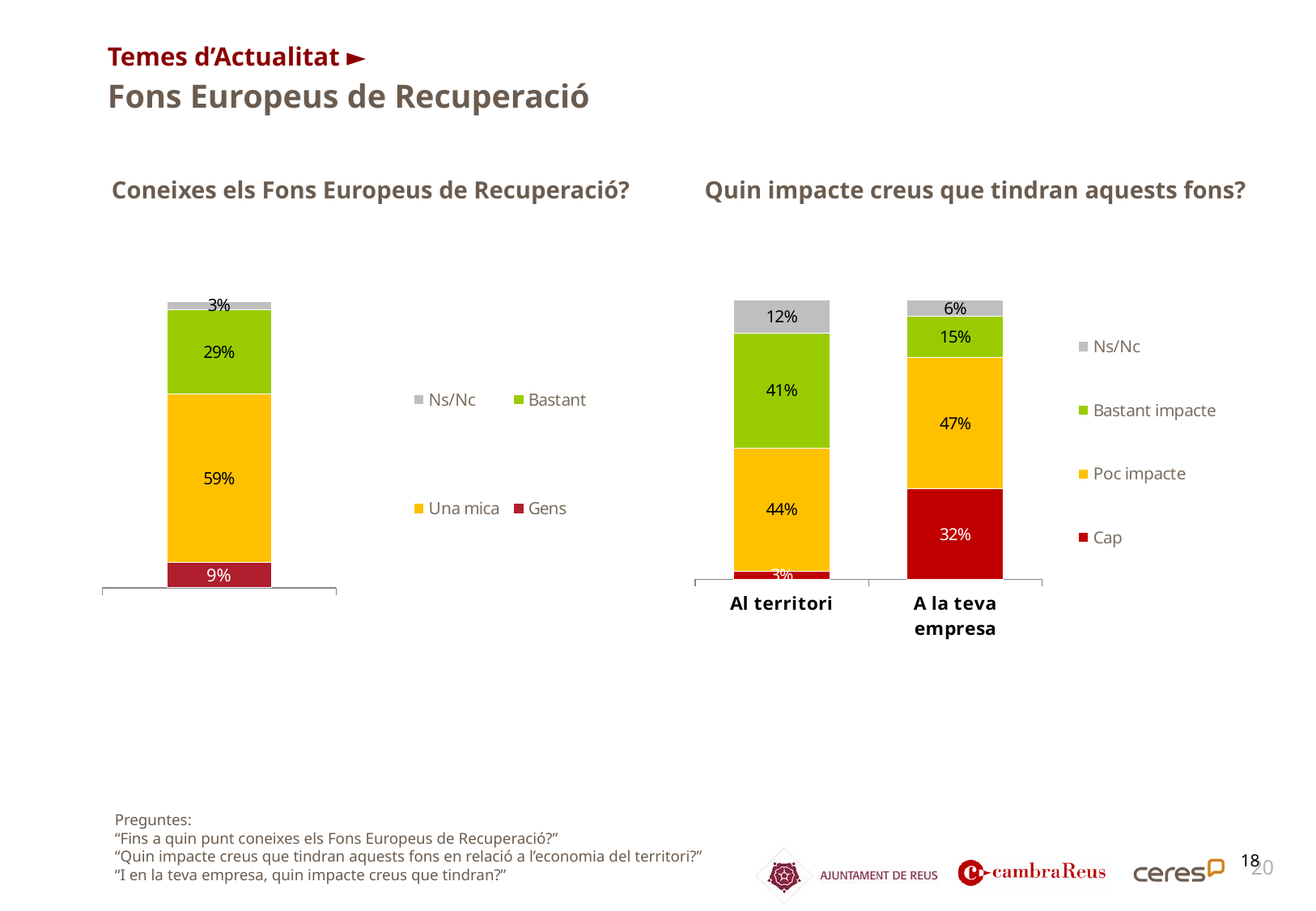
In the chart 'Coneixes els Fons Europeus de Recuperació?', which series has the largest share? Una mica In the chart 'Coneixes els Fons Europeus de Recuperació?', what is the value for 'Una mica'? 59% In the chart 'Quin impacte creus que tindran aquests fons?', what is the difference between the 'Cap' values for 'A la teva empresa' and 'Al territori'? 29% In the chart 'Quin impacte creus que tindran aquests fons?', what is the value for 'Bastant impacte' for 'Al territori'? 41% In the chart 'Quin impacte creus que tindran aquests fons?', how many categories are shown on the x axis? 2 In the chart 'Coneixes els Fons Europeus de Recuperació?', how many series does the legend list? 4 What kind of chart is 'Quin impacte creus que tindran aquests fons?'? Stacked bar chart In the chart 'Coneixes els Fons Europeus de Recuperació?', what is the value for 'Gens'? 9% In the chart 'Quin impacte creus que tindran aquests fons?', which colour represents 'Cap'? Red In the chart 'Quin impacte creus que tindran aquests fons?', what is the value for 'Poc impacte' for 'A la teva empresa'? 47% In the chart 'Quin impacte creus que tindran aquests fons?', what is the value for 'Cap' for 'A la teva empresa'? 32% In the chart 'Quin impacte creus que tindran aquests fons?', which category has the higher 'Ns/Nc' value, 'Al territori' or 'A la teva empresa'? Al territori